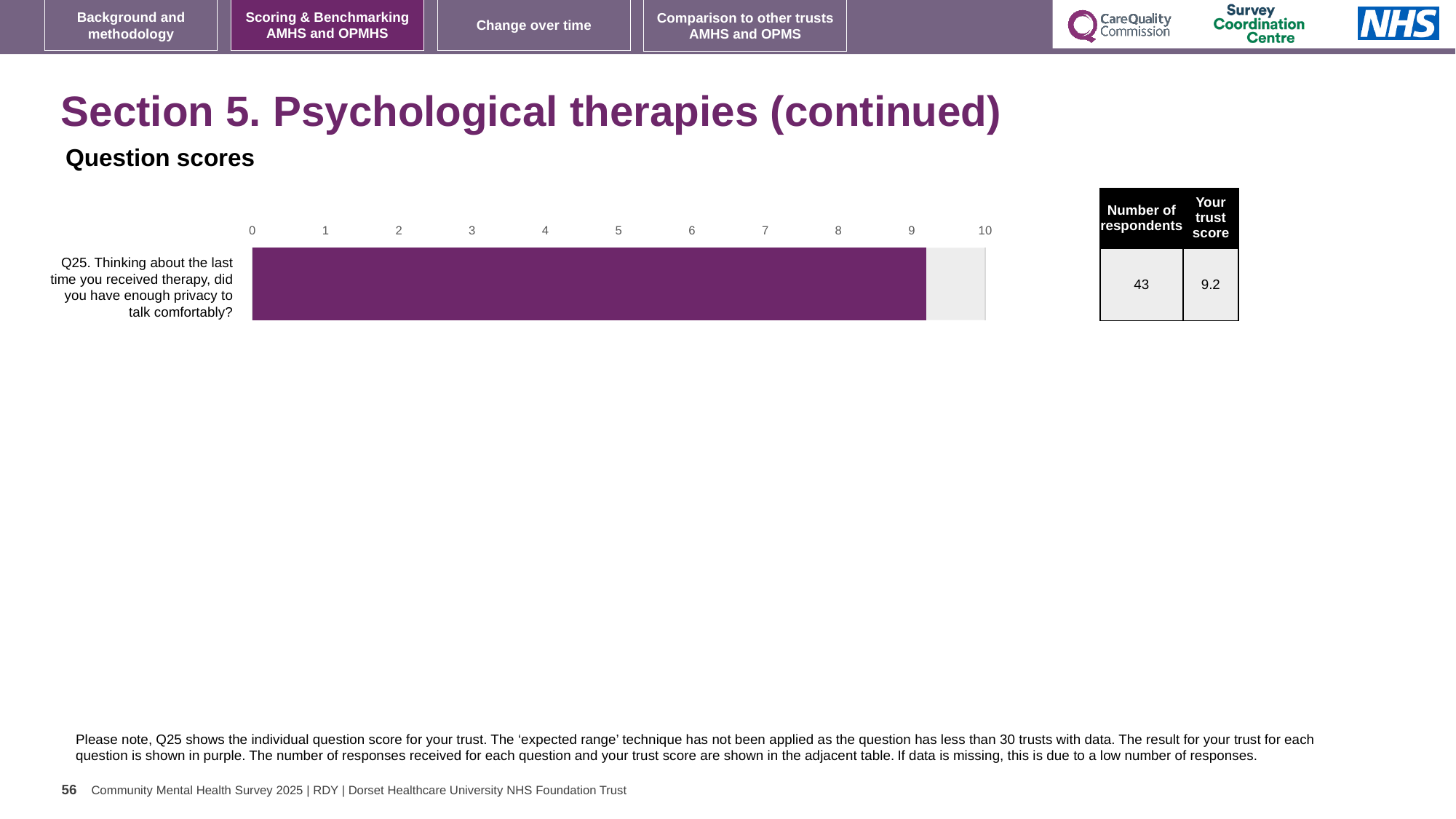
What is the maximum value shown on the chart's axis? 10 What kind of chart is shown on the slide? bar chart What colour is the bar for Q25? purple Is the value for Q25 greater or less than 8? greater Is the value for Q25 greater or less than 5? greater How many respondents answered Q25 according to the table beside the chart? 43 What is the trust score for Q25 shown in the table next to the chart? 9.2 How many questions are plotted in the chart? 1